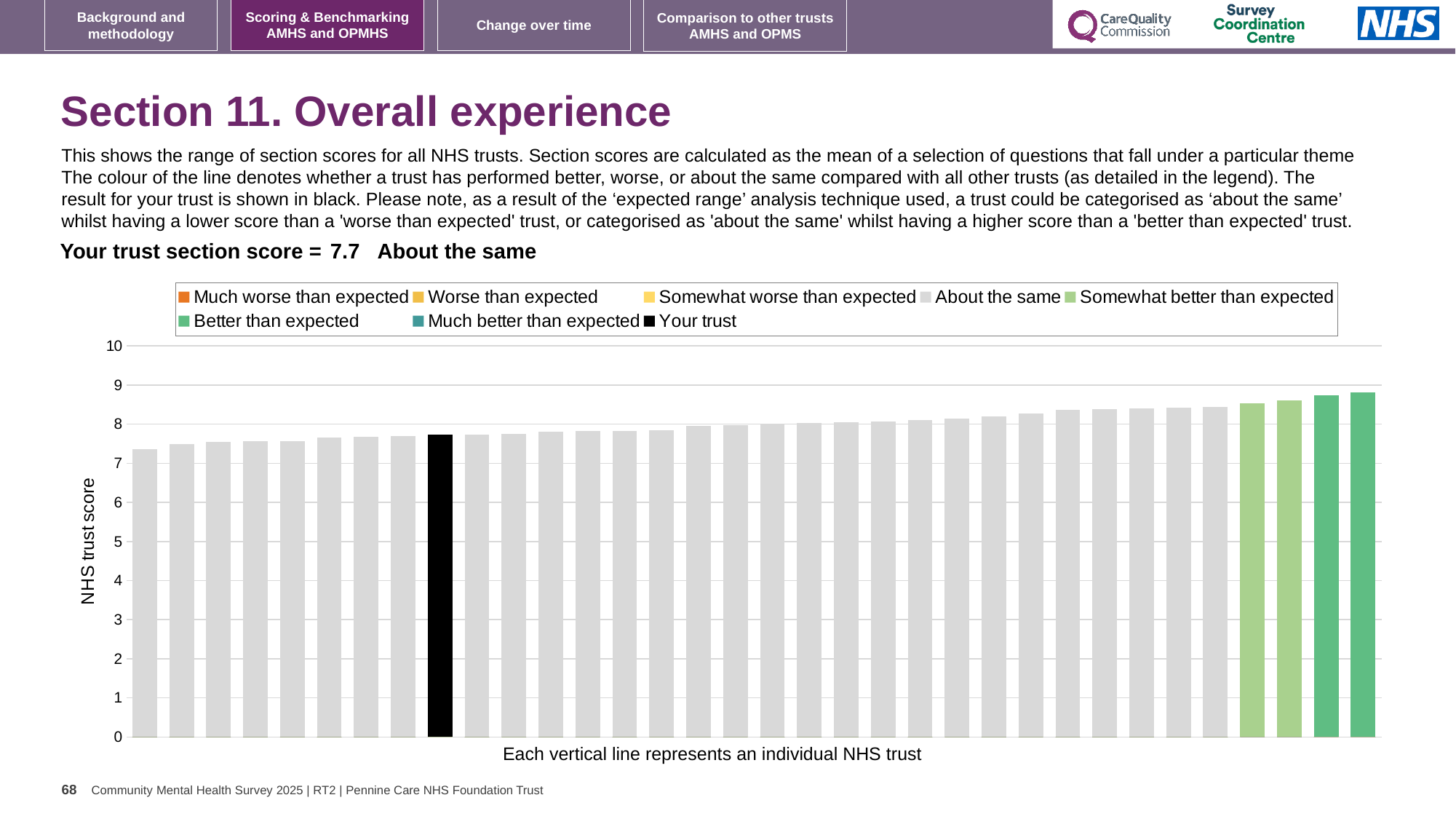
How many bars are coloured as 'Better than expected' (darker green)? 2 What is the section score for your trust shown above the chart? 7.7 Is the value of the leftmost bar greater or less than 8? less What kind of chart is shown on the slide? bar chart Is the value of the black 'Your trust' bar greater or less than 7? greater How many entries does the chart legend list? 8 Is the black 'Your trust' bar higher or lower than the rightmost bar? lower Is the value of the leftmost bar greater or less than 7? greater Which category is your trust placed in for this section? About the same Do the bar values rise or fall from left to right across the chart? rise What is the label on the vertical axis of the chart? NHS trust score